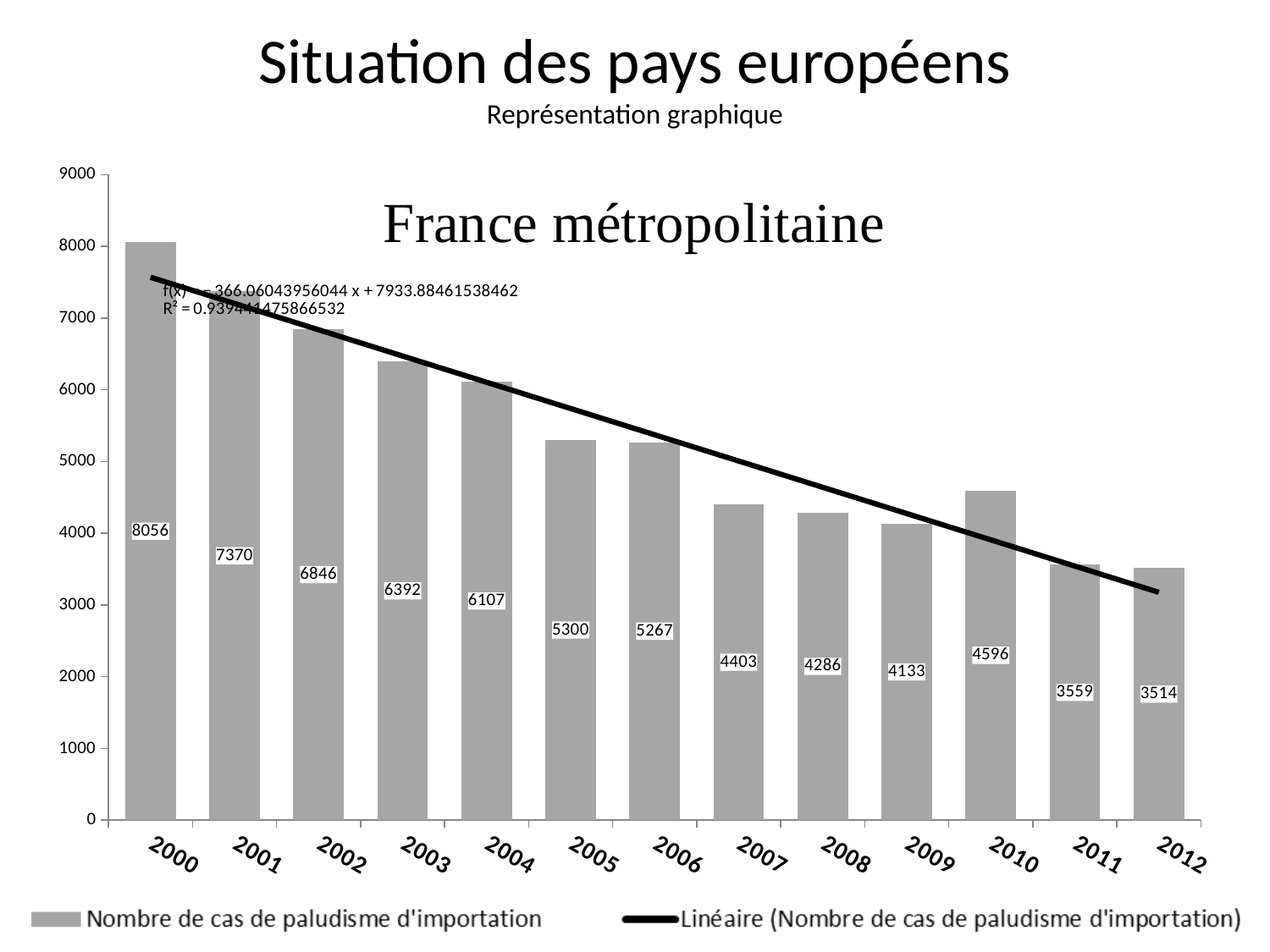
What is the difference between the values for 2009 and 2010? 463 Which year has the lowest number of cases? 2012 Do the values generally rise or fall from 2000 to 2012? Fall What is the value shown for 2010? 4596 How many years are shown on the x axis? 13 What is the value shown for 2012? 3514 What is the title shown inside the chart area? France métropolitaine What is the number of imported malaria cases in France métropolitaine in 2000? 8056 Which year has a larger value, 2005 or 2006? 2005 What is the difference between the values for 2000 and 2012? 4542 What kind of chart is this? Bar chart Which year has the highest number of cases? 2000